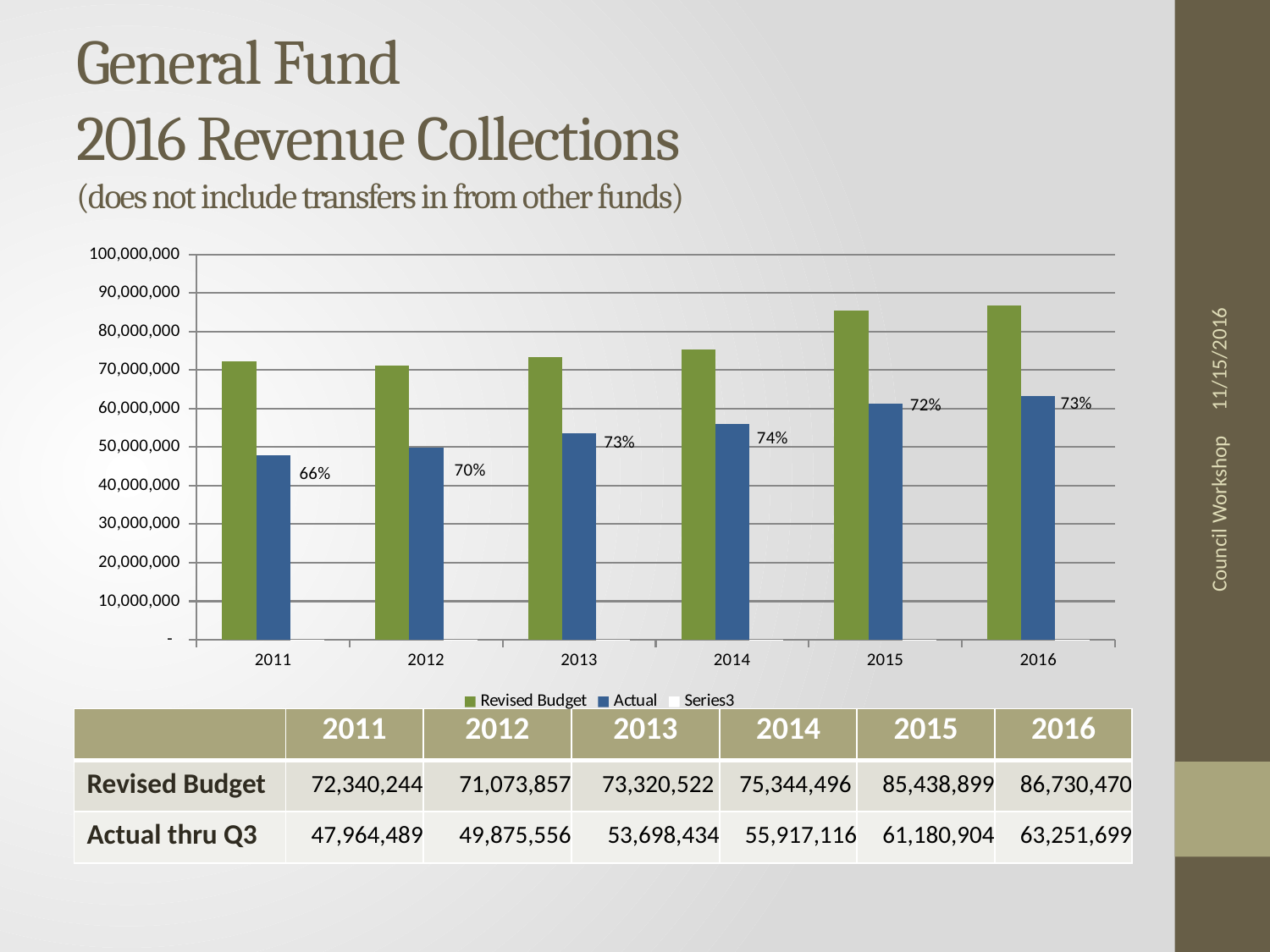
How many series does the chart legend list? 3 Which is larger, the Revised Budget for 2012 or the Revised Budget for 2013? Revised Budget for 2013 How many years are shown along the x axis of the chart? 6 What percentage label is shown on the Actual bar for 2011? 66% What percentage label is shown on the Actual bar for 2014? 74% Which year has the highest percentage label on its Actual bar? 2014 Is the Revised Budget bar for 2015 greater or less than 80,000,000? greater Do the Actual bars rise or fall from 2011 to 2016? rise Which year has the lowest percentage label on its Actual bar? 2011 What kind of chart is shown on the slide? bar chart What is the Actual thru Q3 value for 2013? 53,698,434 What is the Revised Budget value for 2016? 86,730,470